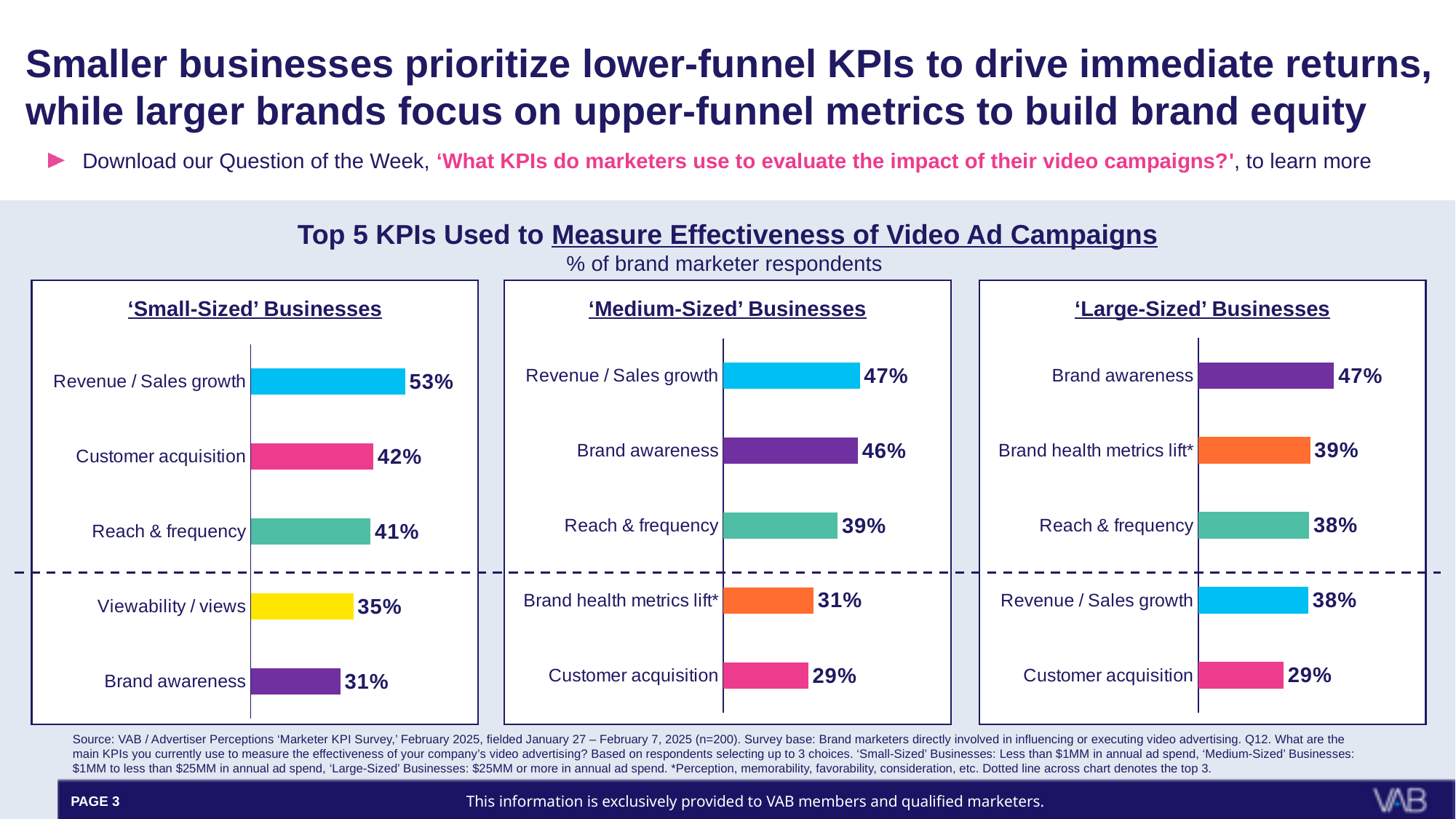
In the 'Medium-Sized' Businesses chart, what is the difference between Reach & frequency and Brand health metrics lift*? 8 percentage points Which is larger: Customer acquisition in the 'Small-Sized' Businesses chart or Customer acquisition in the 'Large-Sized' Businesses chart? 'Small-Sized' Businesses In the 'Small-Sized' Businesses chart, which KPI has the lowest value? Brand awareness What colour is the Brand awareness bar in the 'Small-Sized' Businesses chart? Purple In the 'Large-Sized' Businesses chart, which KPI has the highest value? Brand awareness In the 'Medium-Sized' Businesses chart, which KPI has the lowest value? Customer acquisition What type of chart is used for the 'Large-Sized' Businesses panel? Bar chart How many KPIs are shown in the 'Medium-Sized' Businesses chart? 5 In the 'Small-Sized' Businesses chart, what percentage of respondents use Revenue / Sales growth as a KPI? 53% In the 'Medium-Sized' Businesses chart, what is the value for Brand awareness? 46% In the 'Large-Sized' Businesses chart, what is the value for Brand health metrics lift*? 39% In the 'Small-Sized' Businesses chart, what is the difference between Revenue / Sales growth and Brand awareness? 22 percentage points